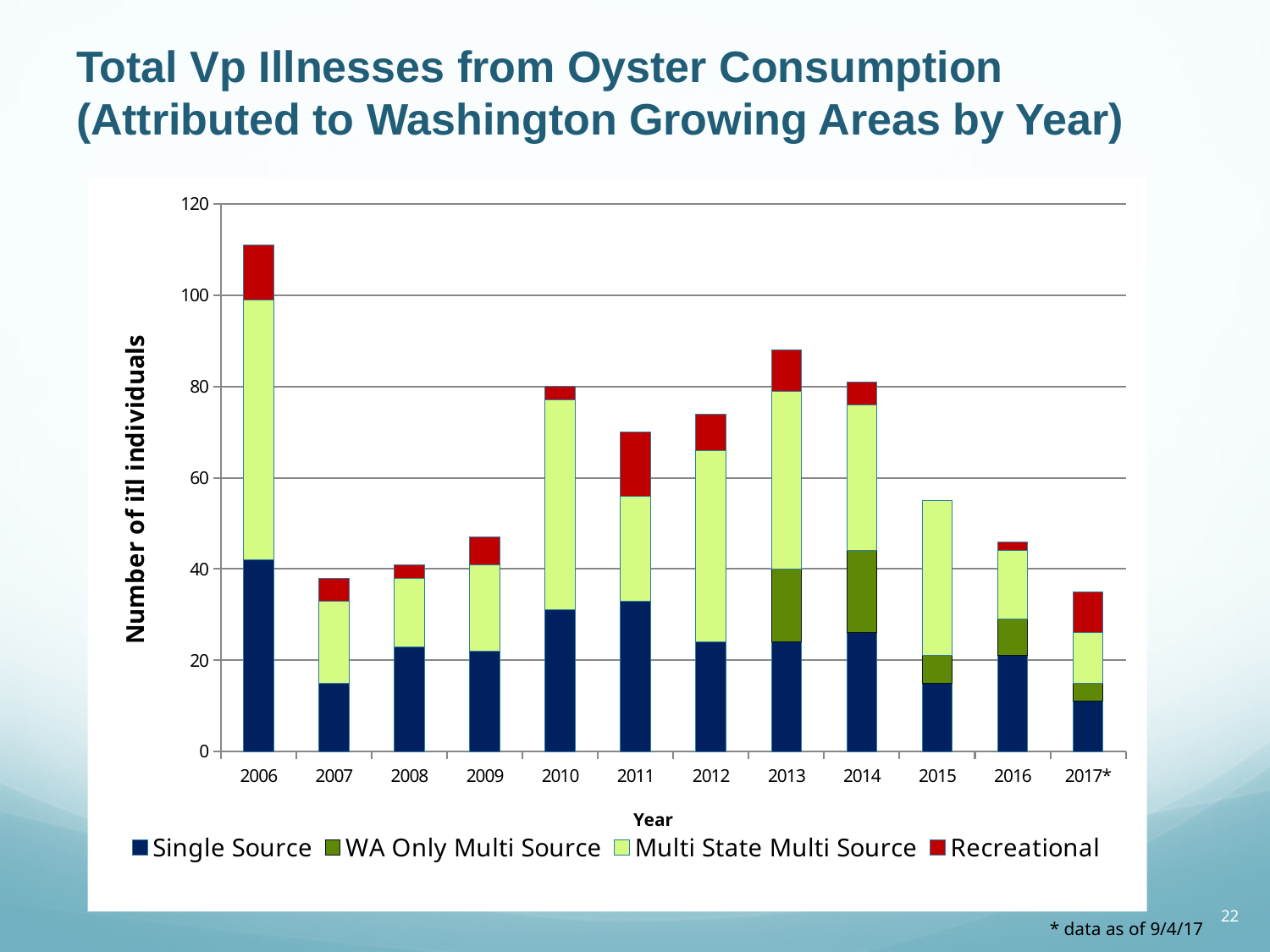
Which year has the highest total number of ill individuals? 2006 Which series is shown in red in the chart's legend? Recreational Is the total number of ill individuals for 2015 greater or less than 60? less What kind of chart is shown on the slide? Stacked bar chart What is the title of the chart's y axis? Number of ill individuals Do the total numbers of ill individuals rise or fall from 2014 to 2017*? fall Is the total number of ill individuals for 2013 greater or less than 80? greater Is the total number of ill individuals for 2007 greater or less than 40? less Which year has the larger total number of ill individuals, 2006 or 2013? 2006 How many series does the chart's legend list? 4 How many years are shown along the x axis of the chart? 12